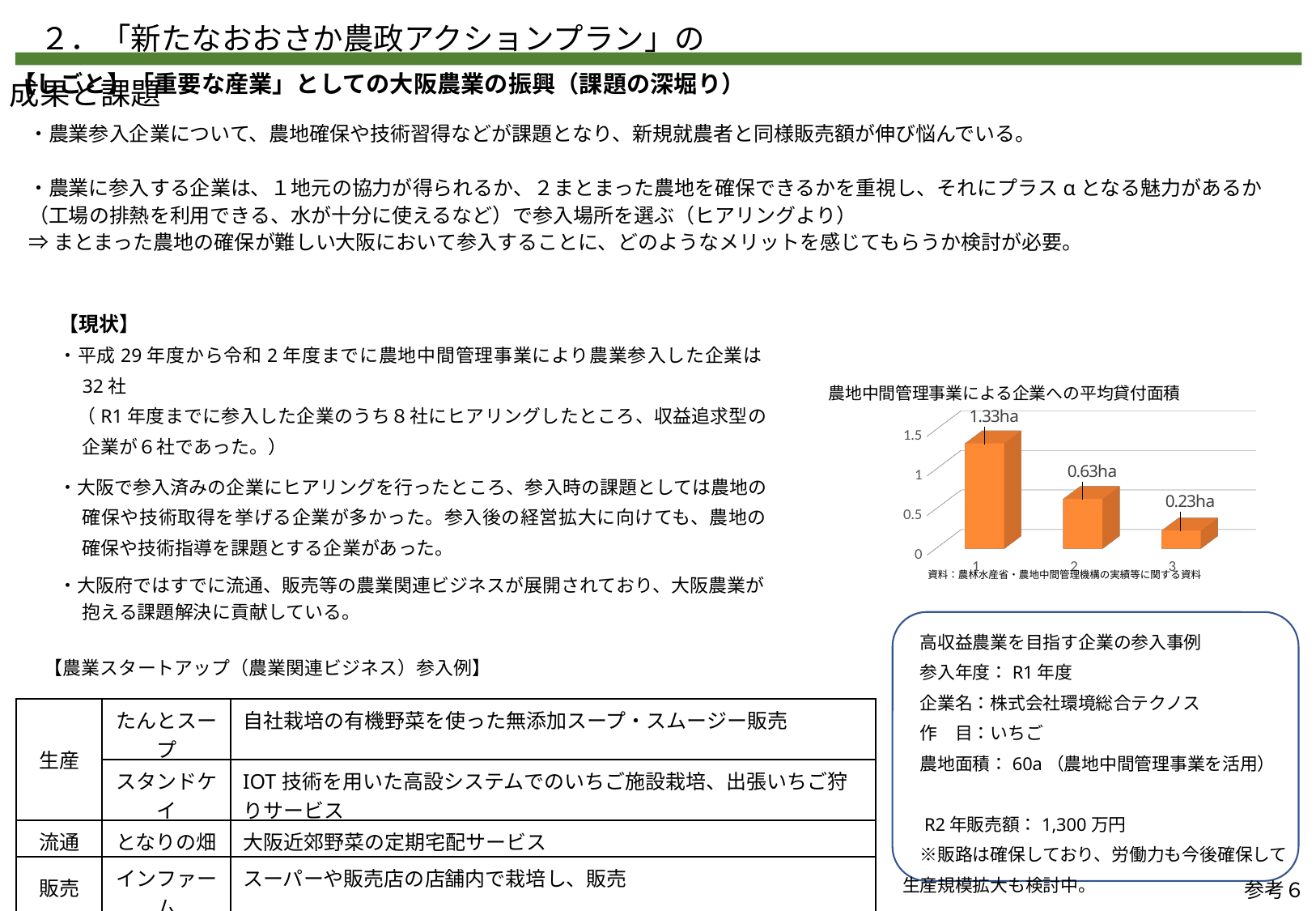
Which category has the highest value in the chart? 1 What is the value for category 1 in the chart? 1.33ha How many bars are plotted in the chart? 3 What is the difference between the values for category 2 and category 3? 0.40ha Which is larger, the value for category 1 or the value for category 3? category 1 What kind of chart is shown on the slide? bar chart What is the difference between the values for category 1 and category 2? 0.70ha What is the value for category 3 in the chart? 0.23ha Which category has the lowest value in the chart? 3 Do the values rise or fall from category 1 to category 3? fall Is the value for category 2 greater or less than 1? less What is the value for category 2 in the chart? 0.63ha